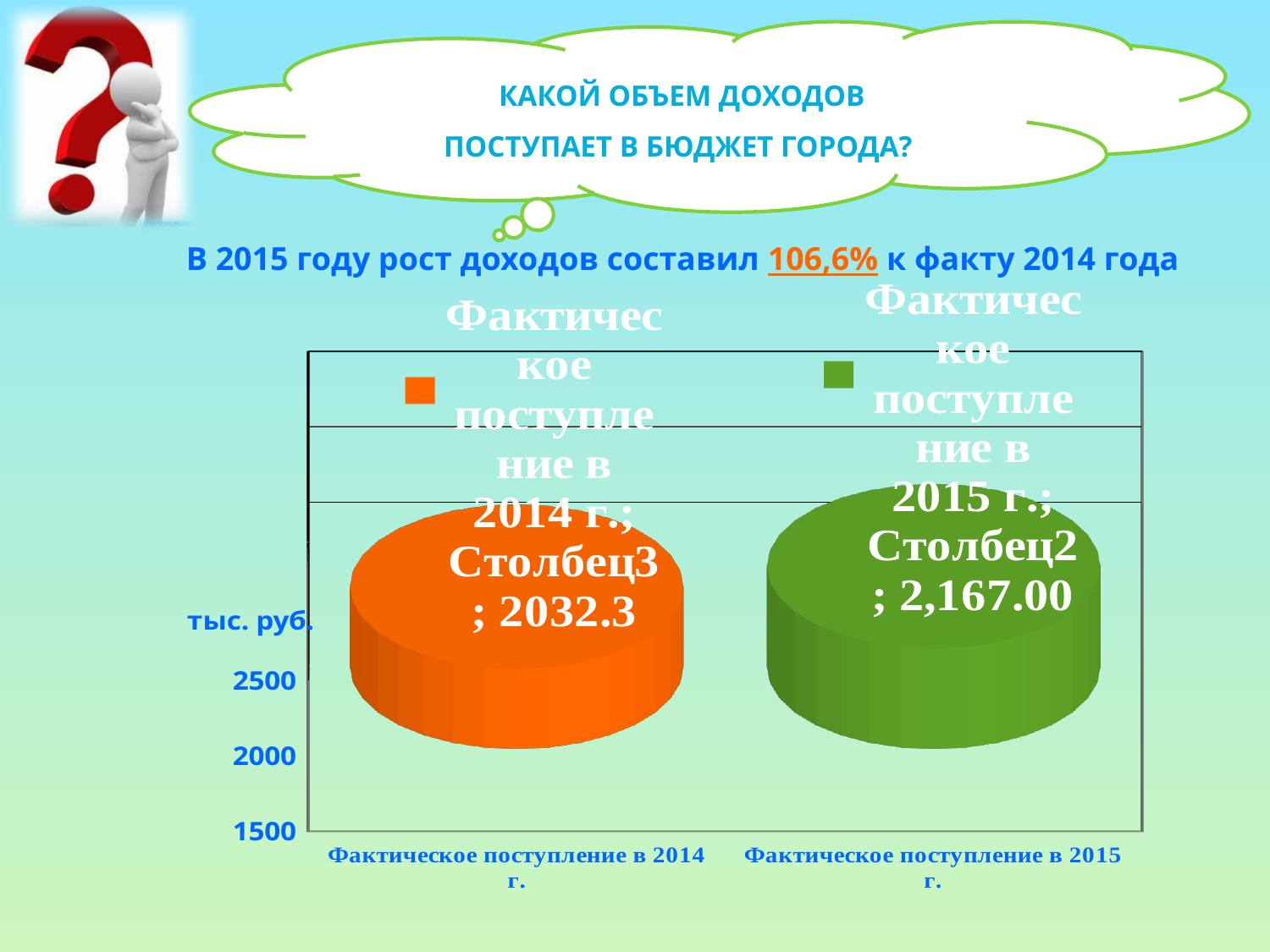
What unit is shown on the vertical axis of the chart? тыс. руб. What kind of chart is shown on the slide? bar chart Is the value for Фактическое поступление в 2015 г. greater or less than 2500? less Which is larger: the value for 2014 г. or the value for 2015 г.? 2015 г. Do the values rise or fall from 2014 г. to 2015 г.? rise Which category has the lowest value? Фактическое поступление в 2014 г. Is the value for Фактическое поступление в 2014 г. greater or less than 2000? greater What is the value for Фактическое поступление в 2015 г.? 2,167.00 How many categories are shown on the chart? 2 What is the difference between the value for 2015 г. and the value for 2014 г.? 134.7 What is the value for Фактическое поступление в 2014 г.? 2032.3 Which category has the highest value? Фактическое поступление в 2015 г.